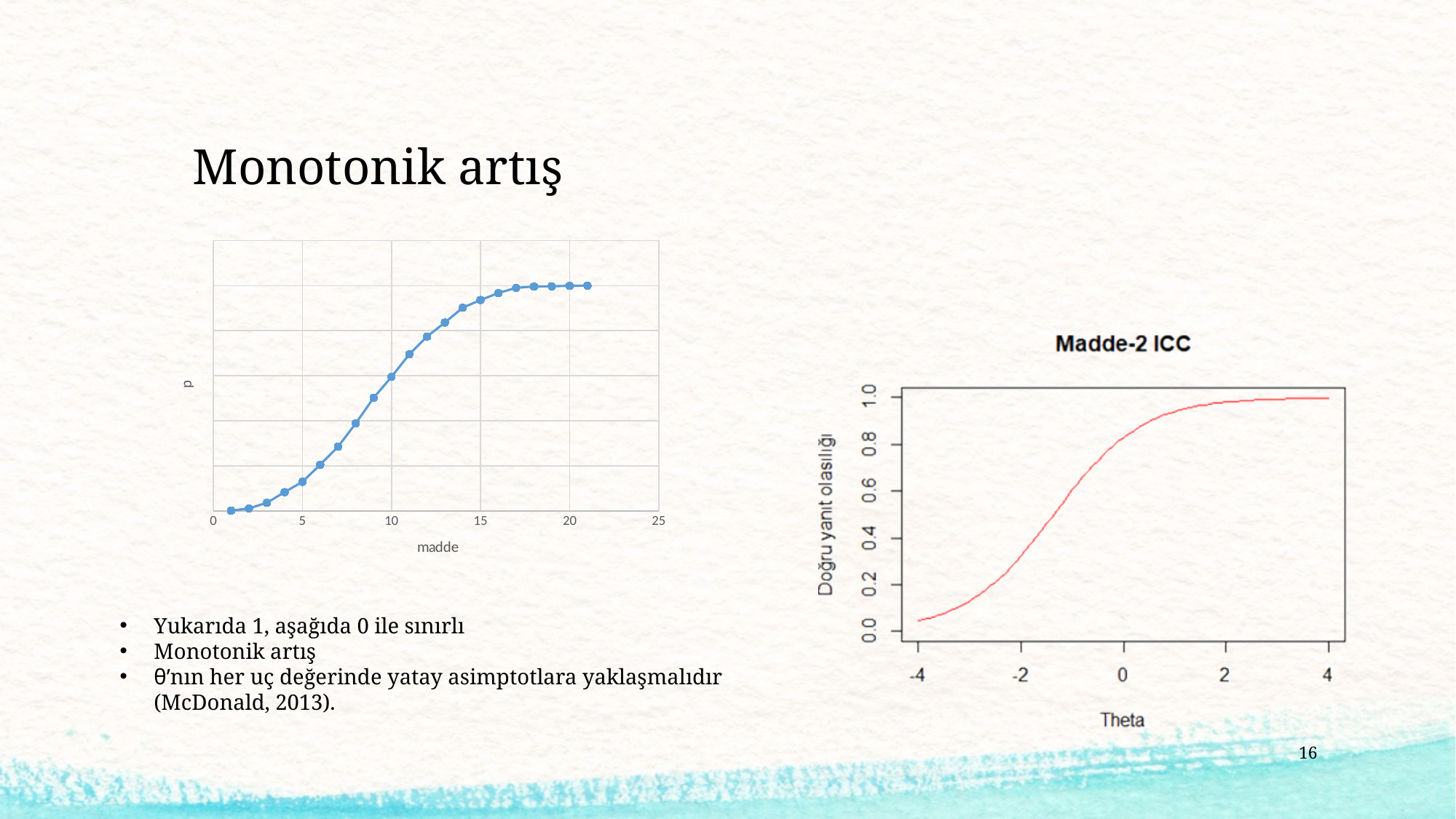
In the chart on the left, what is the label of the x axis? madde In the Madde-2 ICC chart, is the value at Theta = -4 greater or less than 0.2? less What is the title of the chart on the right of the slide? Madde-2 ICC In the Madde-2 ICC chart, does the curve rise or fall as Theta increases? rise In the Madde-2 ICC chart, which is larger: the value at Theta = -2 or the value at Theta = 2? Theta = 2 In the Madde-2 ICC chart, is the value at Theta = 0 greater or less than 0.6? greater In the Madde-2 ICC chart, is the value at Theta = -2 greater or less than 0.6? less What kind of chart is the chart on the left? line chart In the chart on the left, do the values rise or fall as madde increases? rise In the chart on the left, how many data points are plotted? 21 In the chart on the left, which is larger: the value at madde = 5 or the value at madde = 15? madde = 15